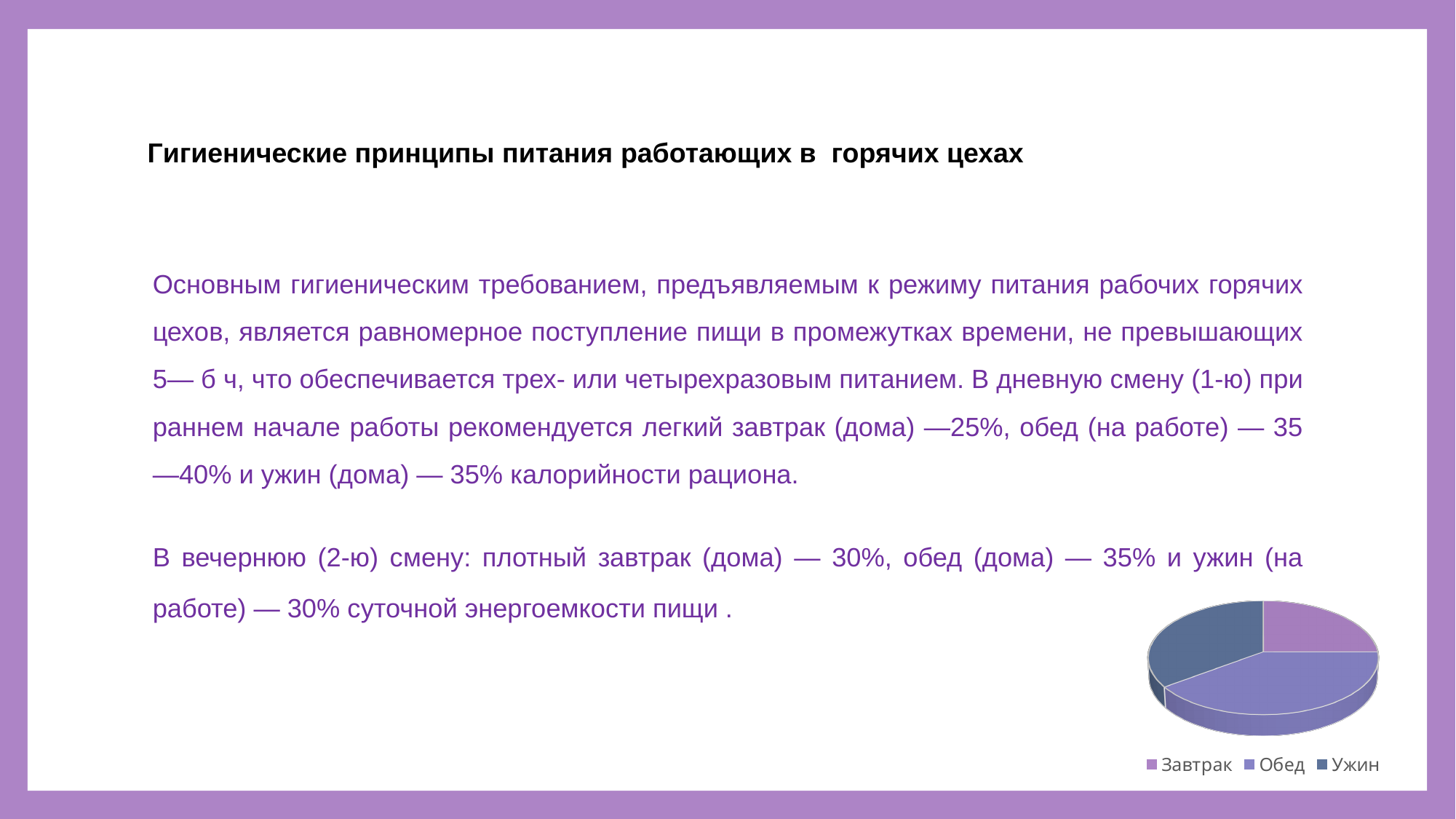
What are the legend entries of the pie chart, in order? Завтрак, Обед, Ужин Which legend entry of the pie chart is shown in the darkest blue colour? Ужин Which category has the smallest slice in the pie chart? Завтрак What kind of chart is shown on the slide? pie chart How many slices does the pie chart have? 3 Which slice is larger in the pie chart, Завтрак or Ужин? Ужин Which category has the largest slice in the pie chart? Обед How many entries does the legend of the pie chart list? 3 Which slice is larger in the pie chart, Завтрак or Обед? Обед